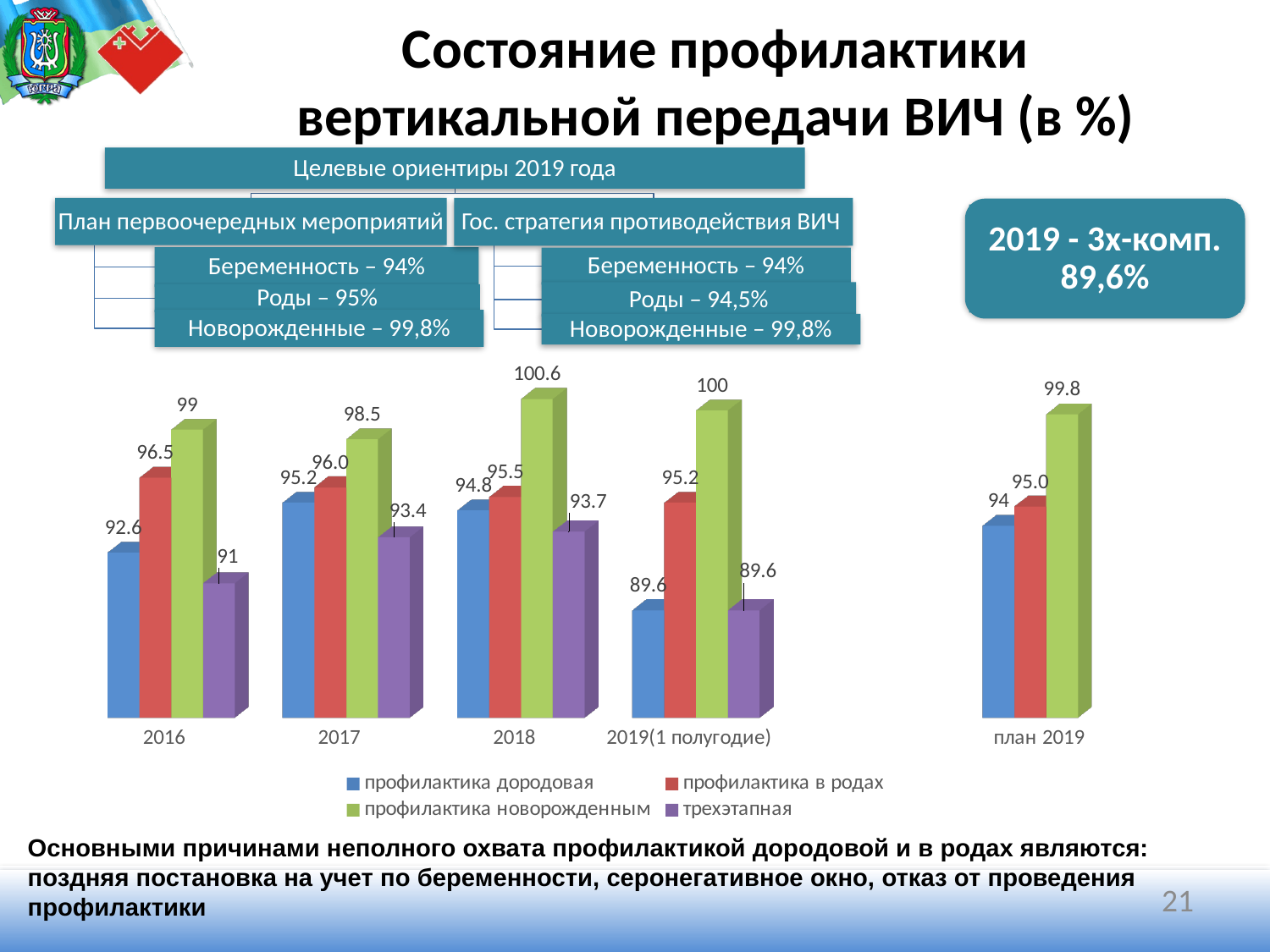
Which series is shown in green in the chart? профилактика новорожденным In which year is the value for профилактика новорожденным the highest? 2018 How many categories are shown on the x axis of the chart? 5 What is the value for профилактика в родах in план 2019? 95.0 In which category is the value for профилактика дородовая the lowest? 2019(1 полугодие) How many series does the legend list? 4 Which is larger: профилактика в родах in 2016 or профилактика в родах in 2018? профилактика в родах in 2016 What is the value for профилактика дородовая in 2019(1 полугодие)? 89.6 What is the difference between профилактика новорожденным and трехэтапная in 2017? 5.1 What is the value for трехэтапная in 2016? 91 What kind of chart is shown on the slide? bar chart What is the value for профилактика новорожденным in 2018? 100.6